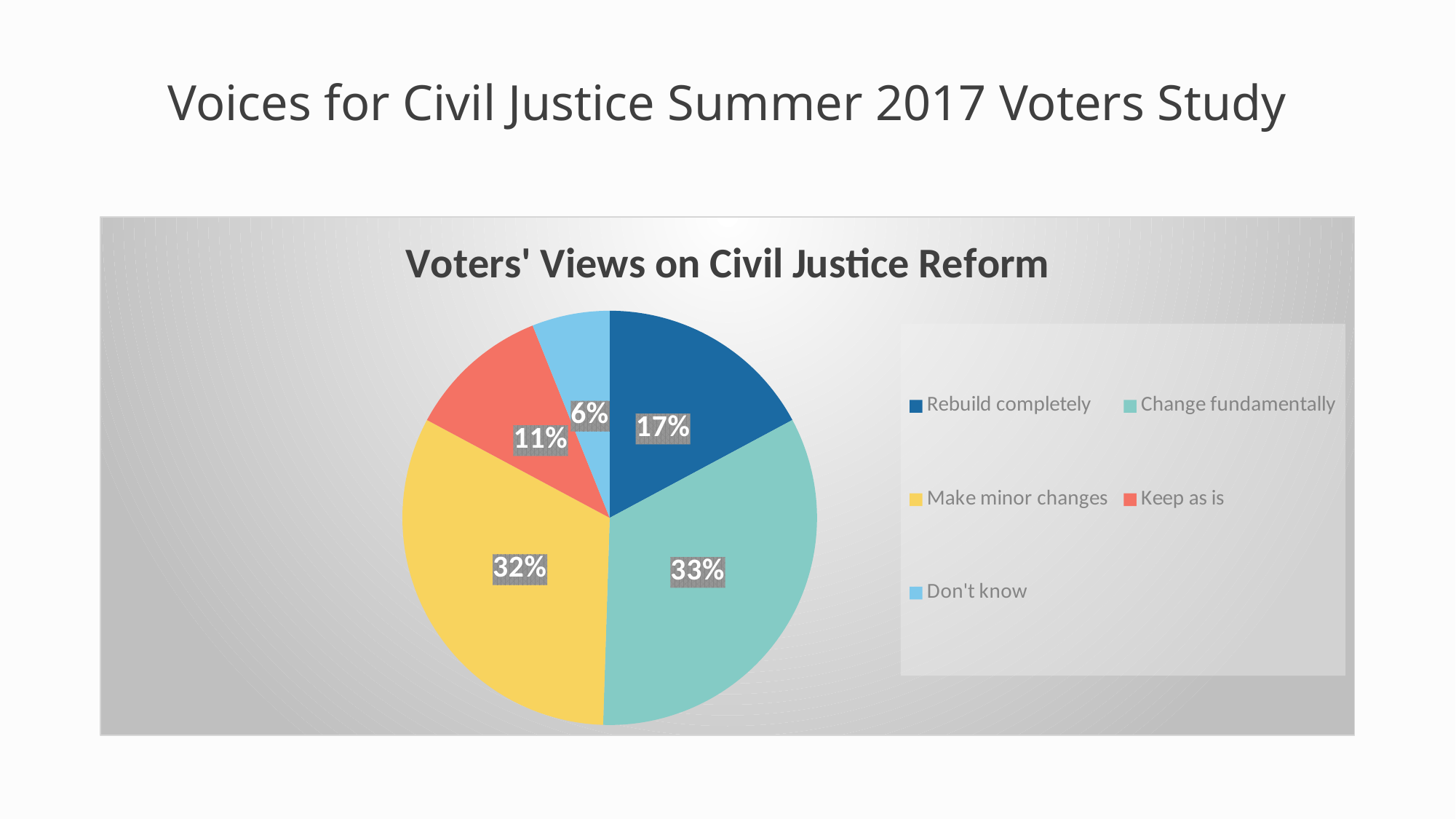
What share of voters said "Change fundamentally"? 33% Which response has the smallest slice of the pie? Don't know How many categories does the pie chart show? 5 Which is larger: the share for "Rebuild completely" or the share for "Keep as is"? Rebuild completely What share of voters said "Rebuild completely"? 17% What kind of chart is shown on the slide? Pie chart What is the title of the chart? Voters' Views on Civil Justice Reform What share of voters said "Keep as is"? 11% What share of voters answered "Don't know"? 6% What is the difference in percentage points between "Make minor changes" and "Keep as is"? 21 Which response has the largest slice of the pie? Change fundamentally What colour is the "Make minor changes" slice? Yellow